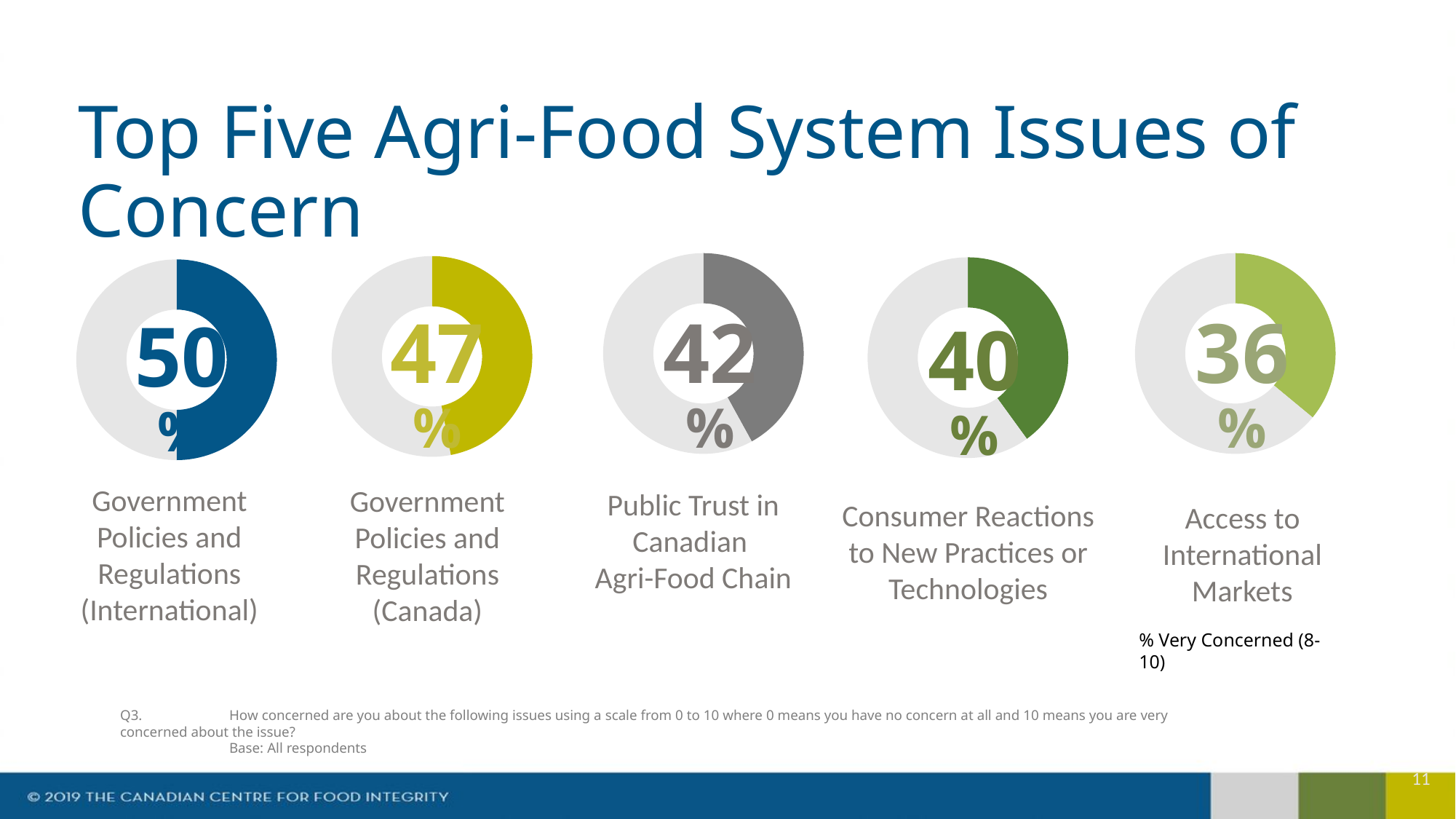
What percentage of respondents are very concerned about Access to International Markets? 36% What is the difference in percentage points between Government Policies and Regulations (International) and Access to International Markets? 14 Which issue has the lowest percentage of very concerned respondents? Access to International Markets Which has a higher percentage of very concerned respondents: Public Trust in Canadian Agri-Food Chain or Consumer Reactions to New Practices or Technologies? Public Trust in Canadian Agri-Food Chain What percentage of respondents are very concerned about Government Policies and Regulations (International)? 50% How many issues are shown on the slide? 5 What percentage of respondents are very concerned about Government Policies and Regulations (Canada)? 47% Which issue has the highest percentage of very concerned respondents? Government Policies and Regulations (International) What percentage of respondents are very concerned about Consumer Reactions to New Practices or Technologies? 40% What is the difference in percentage points between Government Policies and Regulations (Canada) and Public Trust in Canadian Agri-Food Chain? 5 What percentage of respondents are very concerned about Public Trust in Canadian Agri-Food Chain? 42% What kind of chart is used to show each issue's percentage? Donut chart